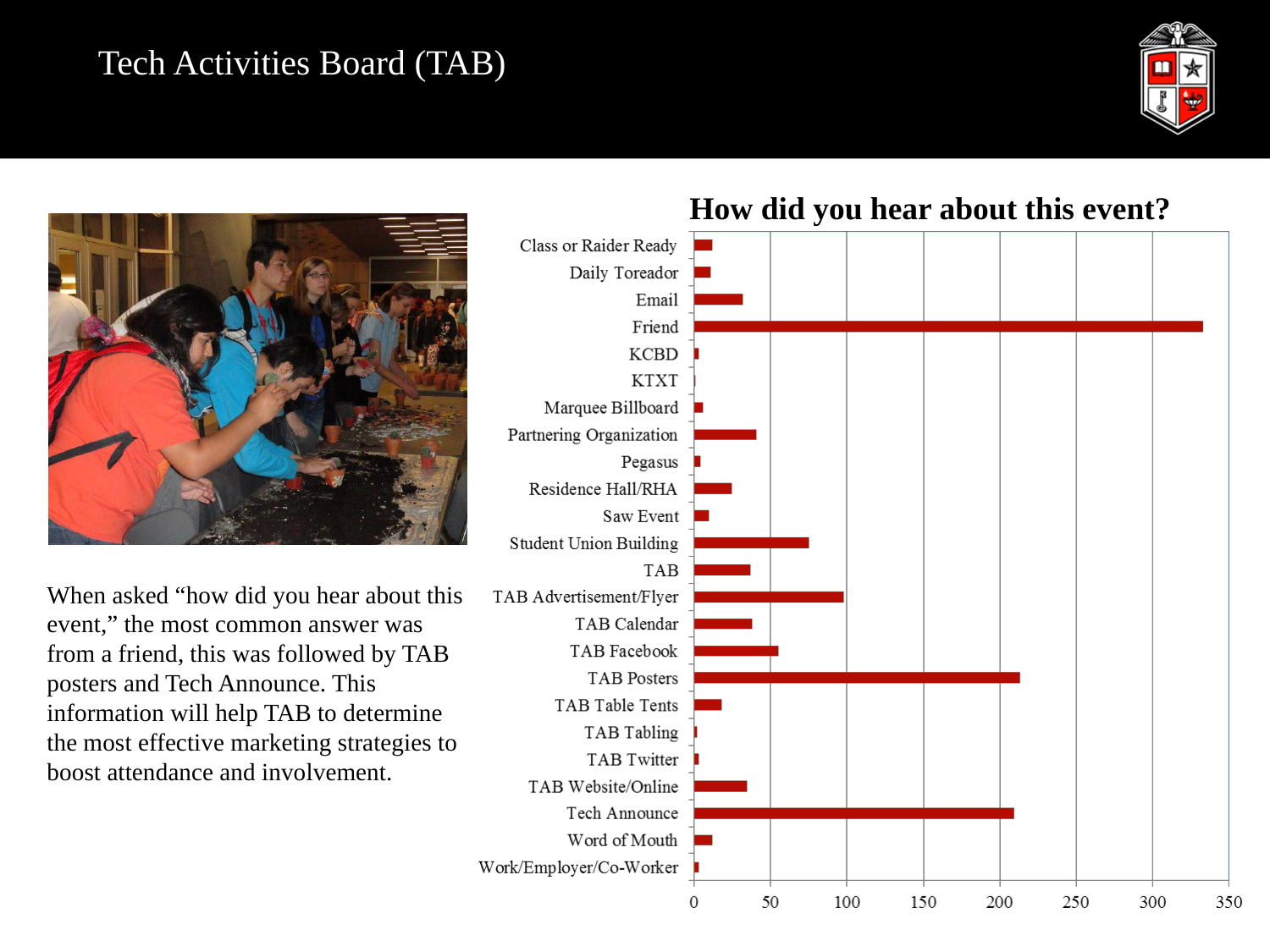
Is the value for TAB Posters greater or less than 200? greater Which is larger, the value for Student Union Building or the value for TAB Facebook? Student Union Building Is the value for Partnering Organization greater or less than 50? less Which category has the highest value in the chart? Friend How many categories are plotted in the chart? 24 What kind of chart is shown on the slide? Bar chart Which is larger, the value for TAB Advertisement/Flyer or the value for Email? TAB Advertisement/Flyer Is the value for Friend greater or less than 300? greater What is the title of the chart? How did you hear about this event? What is the highest value shown on the horizontal axis of the chart? 350 Which is larger, the value for Friend or the value for TAB Posters? Friend